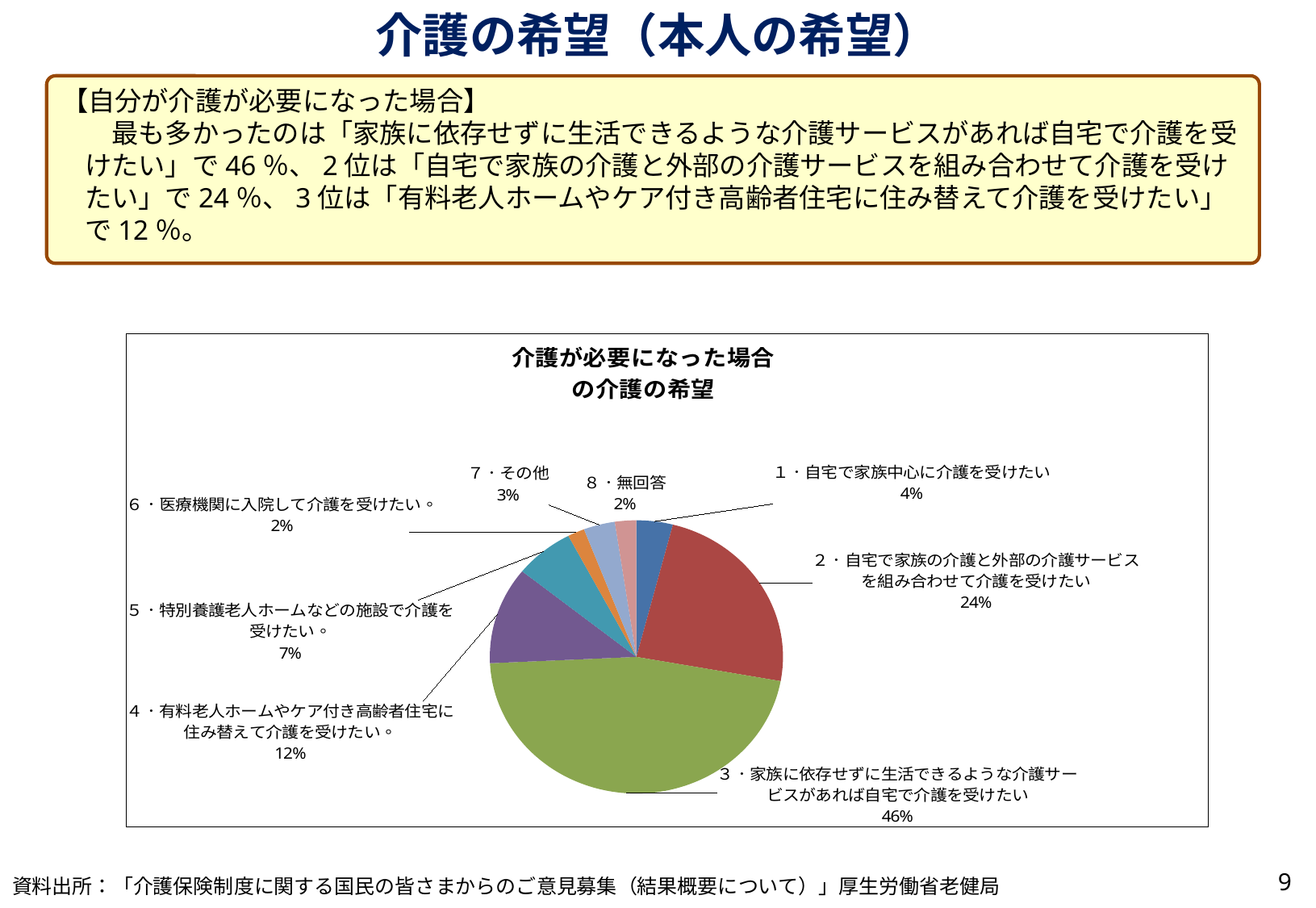
What percentage is shown for 「2・自宅で家族の介護と外部の介護サービスを組み合わせて介護を受けたい」? 24% What percentage is shown for 「3・家族に依存せずに生活できるような介護サービスがあれば自宅で介護を受けたい」? 46% What is the combined share of 「6・医療機関に入院して介護を受けたい」 and 「8・無回答」? 4% What is the title of the chart? 介護が必要になった場合の介護の希望 What percentage is shown for 「7・その他」? 3% Which is larger: the share for 「4・有料老人ホームやケア付き高齢者住宅に住み替えて介護を受けたい」 or for 「5・特別養護老人ホームなどの施設で介護を受けたい」? 4・有料老人ホームやケア付き高齢者住宅に住み替えて介護を受けたい Which category has the largest share of the pie? 3・家族に依存せずに生活できるような介護サービスがあれば自宅で介護を受けたい What percentage is shown for 「5・特別養護老人ホームなどの施設で介護を受けたい」? 7% What is the difference in percentage points between 「3・家族に依存せずに生活できるような介護サービスがあれば自宅で介護を受けたい」 and 「2・自宅で家族の介護と外部の介護サービスを組み合わせて介護を受けたい」? 22 What type of chart is shown on the slide? pie chart What percentage is shown for 「1・自宅で家族中心に介護を受けたい」? 4% How many categories (slices) does the pie chart have? 8